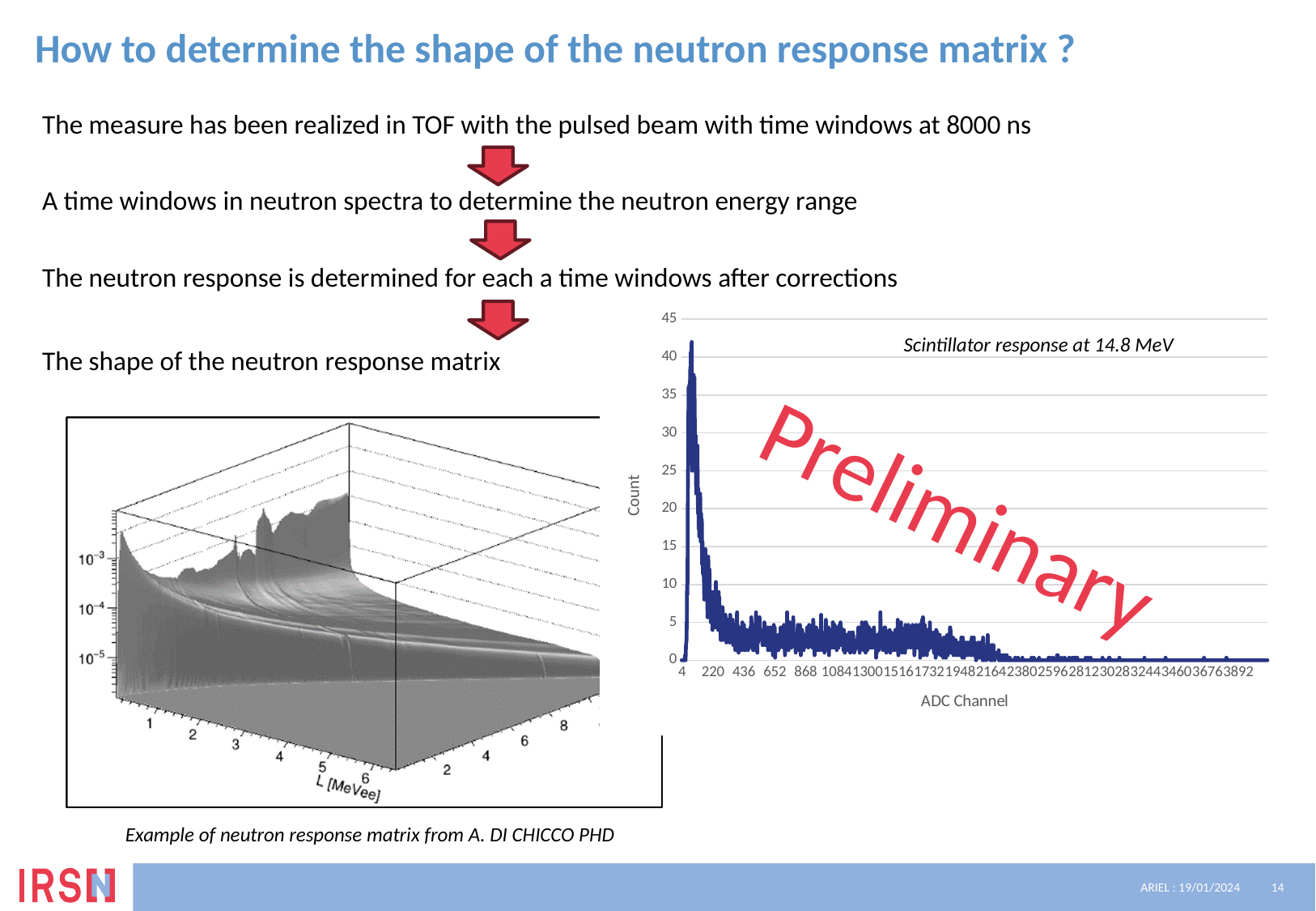
In the 'Scintillator response at 14.8 MeV' chart, is the peak count value greater or less than 35? greater In the 'Scintillator response at 14.8 MeV' chart, what is the label of the horizontal axis? ADC Channel In the 'Scintillator response at 14.8 MeV' chart, what is the last tick label on the horizontal axis? 3892 In the 'Scintillator response at 14.8 MeV' chart, do the counts overall rise or fall as the ADC channel increases? fall How many data series are plotted in the 'Scintillator response at 14.8 MeV' chart? 1 In the 'Scintillator response at 14.8 MeV' chart, what is the first tick label on the horizontal axis? 4 In the 'Scintillator response at 14.8 MeV' chart, what is the highest value shown on the vertical axis? 45 What kind of chart is the 'Scintillator response at 14.8 MeV' chart? line chart What is the title of the chart on the right side of the slide? Scintillator response at 14.8 MeV In the 'Scintillator response at 14.8 MeV' chart, is the count near ADC channel 1300 greater or less than 15? less In the 'Scintillator response at 14.8 MeV' chart, what is the label of the vertical axis? Count In the 'Scintillator response at 14.8 MeV' chart, is the count at ADC channel 3892 greater or less than 5? less